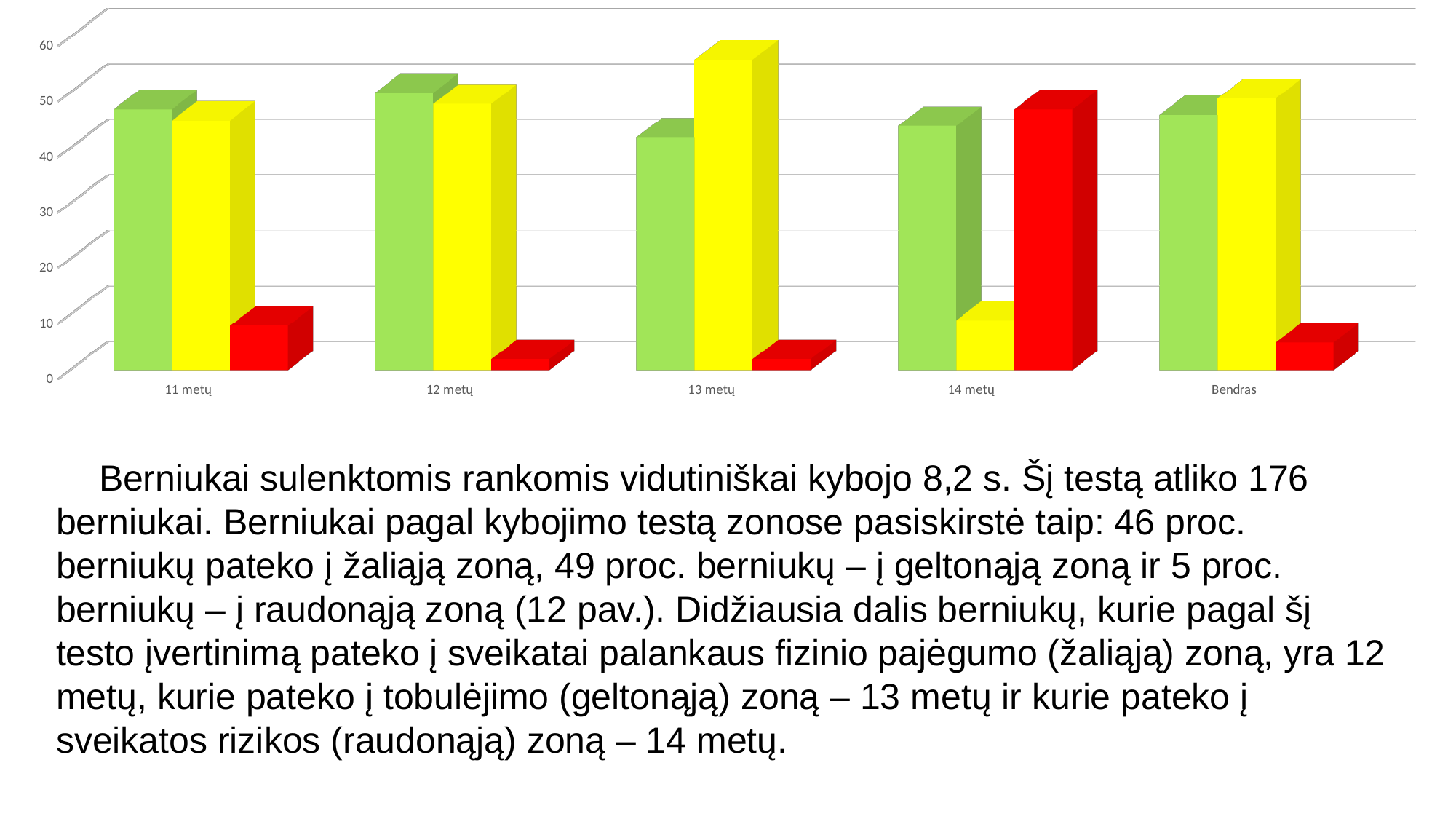
How many bars are plotted for each category in the chart? 3 How many categories are shown on the x axis of the chart? 5 Is the value of the green bar for Bendras greater or less than 40? greater Is the value of the yellow bar for 13 metų greater or less than 50? greater For 14 metų, which bar is taller, the red bar or the yellow bar? the red bar Which category has the shortest yellow bar? 14 metų Which category has the tallest yellow bar? 13 metų What kind of chart is shown on the slide? bar chart For 13 metų, which bar is taller, the green bar or the yellow bar? the yellow bar Which category has the tallest red bar? 14 metų Is the value of the red bar for 14 metų greater or less than 40? greater